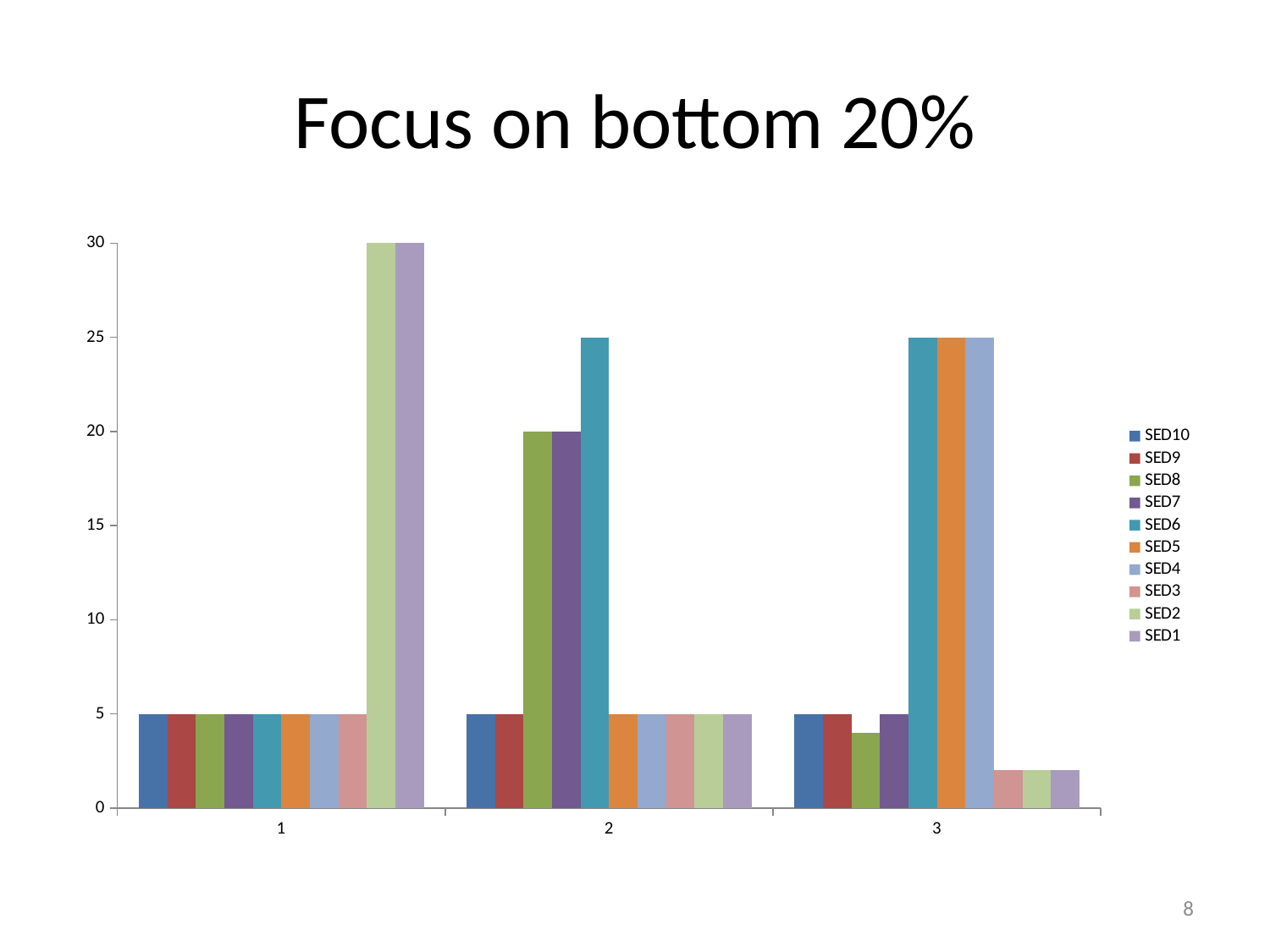
Do the values for SED1 rise or fall from category 1 to category 3? fall What is the value of SED2 in category 1? 30 How many series does the legend list? 10 Which series has the highest value in category 2? SED6 What kind of chart is shown on the slide? bar chart What is the title of the chart? Focus on bottom 20% What is the value of SED6 in category 2? 25 In category 2, which is larger, SED6 or SED7? SED6 How many categories are shown on the x axis? 3 Is the value for SED3 in category 3 greater or less than 5? less What is the value of SED8 in category 2? 20 What is the difference between SED6 and SED8 in category 2? 5